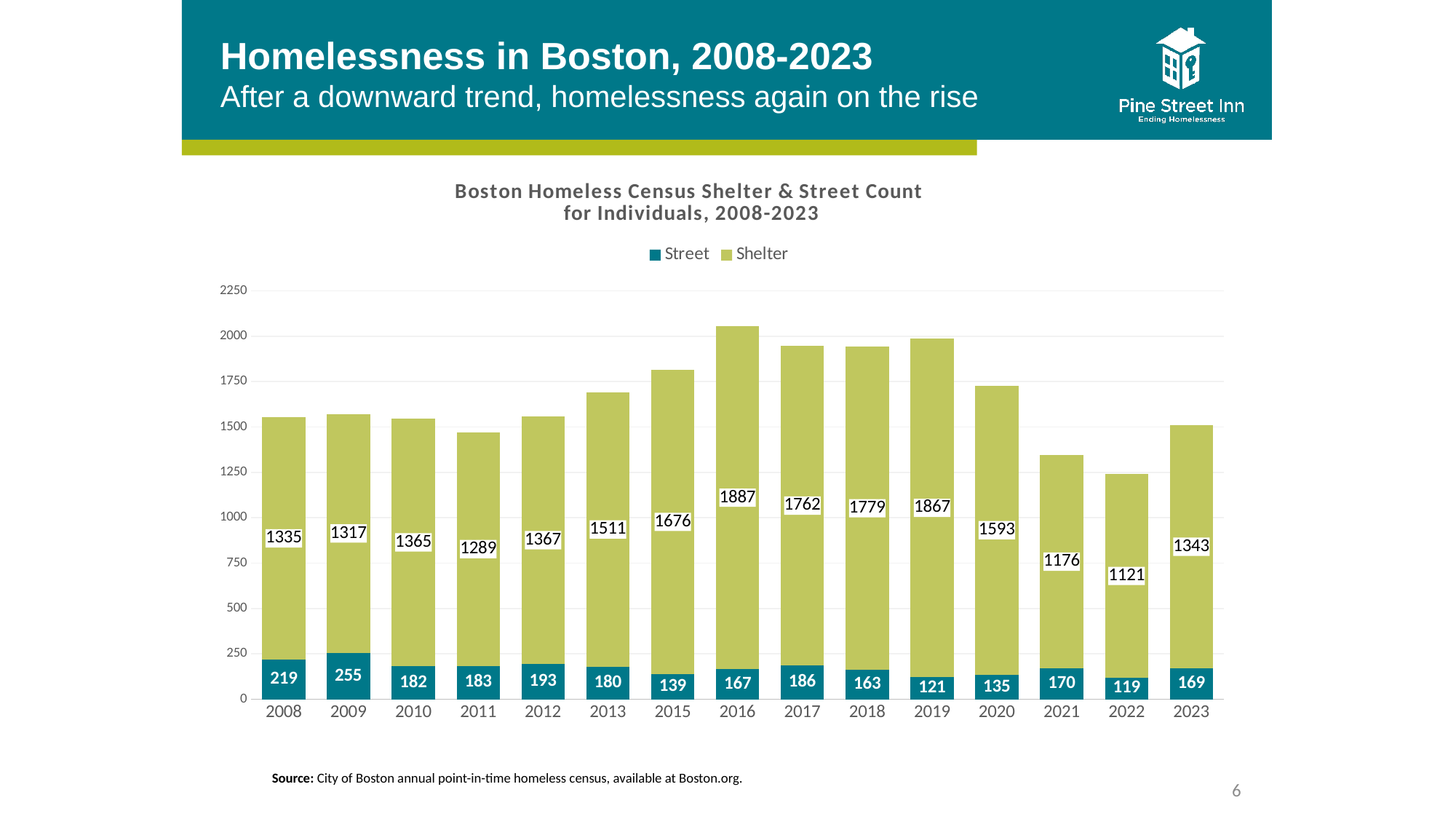
Which year has the highest Shelter value? 2016 What is the Street value for 2009? 255 What is the difference between the Shelter values for 2019 and 2020? 274 How many years are shown on the x axis? 15 Which year has the lowest Street value? 2022 What kind of chart is shown? Stacked bar chart What is the total of the stacked bar for 2022? 1240 How many series does the legend list? 2 What is the Shelter value for 2022? 1121 What is the Shelter value for 2016? 1887 Which is larger, the Street value for 2008 or the Street value for 2023? 2008 Which series is shown in dark teal? Street